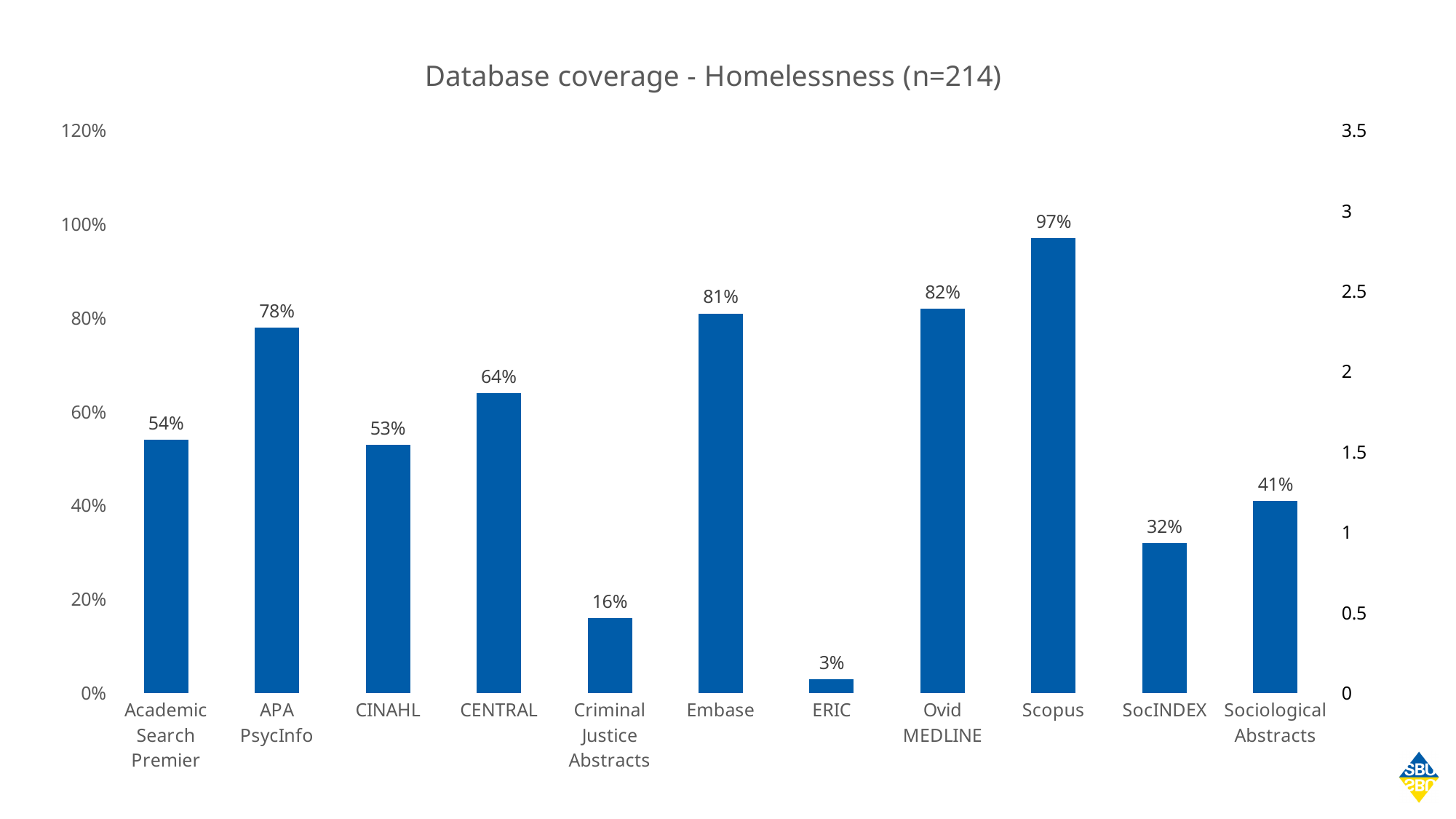
What type of chart is shown on the slide? Bar chart What is the database coverage value for Scopus? 97% What is the database coverage value for Criminal Justice Abstracts? 16% What is the difference in coverage between Scopus and ERIC? 94% Which has higher coverage, Embase or CENTRAL? Embase What is the difference in coverage between APA PsycInfo and CINAHL? 25% What is the title of the chart? Database coverage - Homelessness (n=214) What is the database coverage value for Ovid MEDLINE? 82% How many databases are shown on the chart? 11 Is the value for Sociological Abstracts greater or less than 40%? greater Which database has the highest coverage? Scopus Which database has the lowest coverage? ERIC